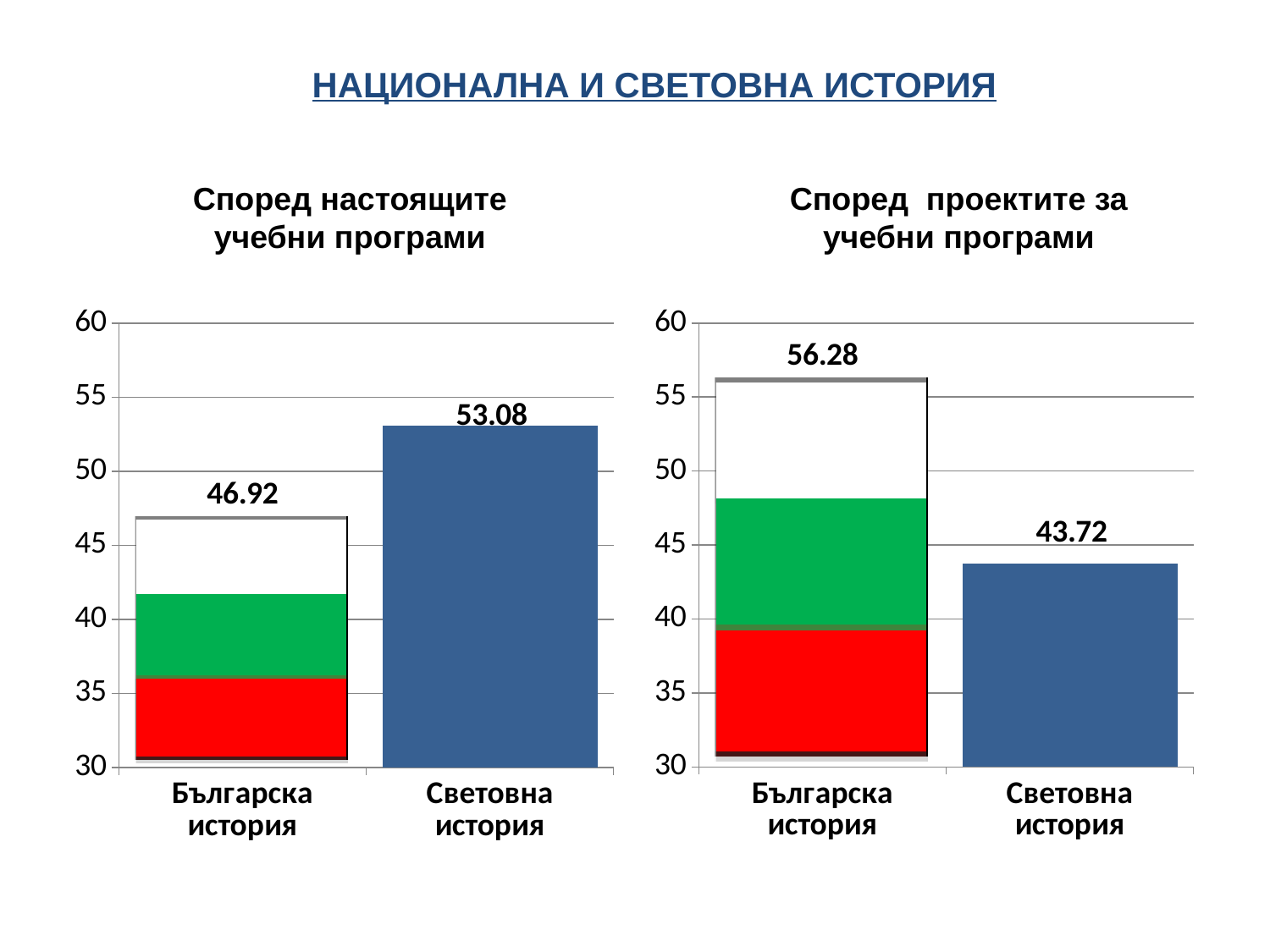
In the right chart (Според проектите за учебни програми), what is the difference between the values for Българска история and Световна история? 12.56 In the left chart (Според настоящите учебни програми), which category has the higher value? Световна история How many categories are shown in the right chart (Според проектите за учебни програми)? 2 In the left chart (Според настоящите учебни програми), is the value for Българска история greater or less than 50? less Is the value for Българска история in the right chart (Според проектите за учебни програми) larger than the value for Българска история in the left chart (Според настоящите учебни програми)? Yes In the left chart (Според настоящите учебни програми), what is the value for Българска история? 46.92 In the left chart (Според настоящите учебни програми), what is the difference between the values for Световна история and Българска история? 6.16 In the right chart (Според проектите за учебни програми), what is the value for Световна история? 43.72 What type of chart is the left chart (Според настоящите учебни програми)? Bar chart In the right chart (Според проектите за учебни програми), what is the value for Българска история? 56.28 In the right chart (Според проектите за учебни програми), which category has the lower value? Световна история In the left chart (Според настоящите учебни програми), what is the value for Световна история? 53.08